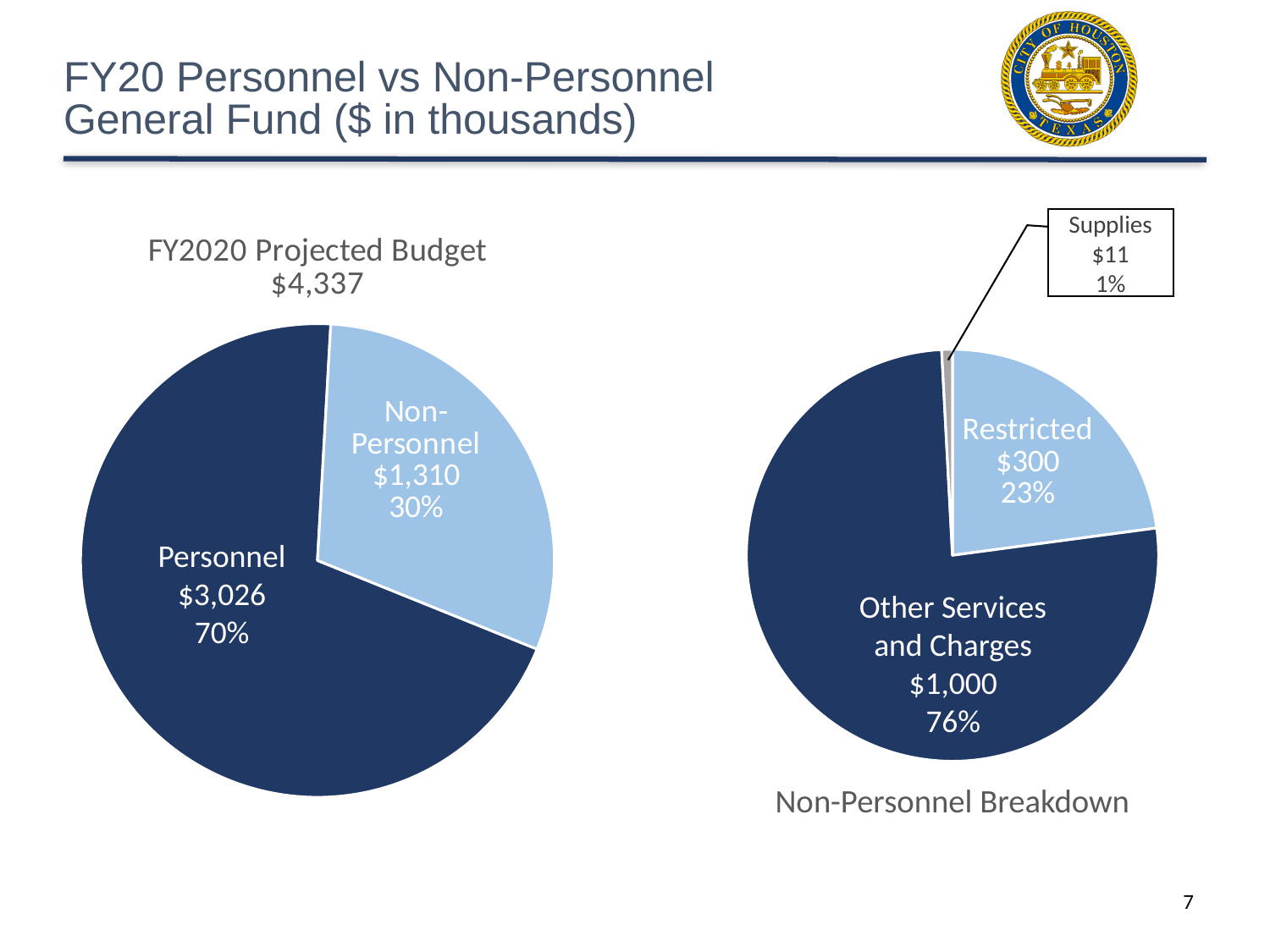
In the FY2020 Projected Budget chart, what share of the pie is Non-Personnel? 30% In the Non-Personnel Breakdown chart, which category is the smallest? Supplies In the FY2020 Projected Budget chart, what is the difference between Personnel and Non-Personnel? $1,716 In the Non-Personnel Breakdown chart, which is larger, Restricted or Other Services and Charges? Other Services and Charges What total is shown under the FY2020 Projected Budget chart title? $4,337 In the Non-Personnel Breakdown chart, what is the value for Restricted? $300 What kind of chart is the FY2020 Projected Budget chart? Pie chart In the FY2020 Projected Budget chart, which category is the largest? Personnel In the Non-Personnel Breakdown chart, what share of the pie is Other Services and Charges? 76% In the FY2020 Projected Budget chart, what is the value for Personnel? $3,026 In the Non-Personnel Breakdown chart, how many categories are shown? 3 In the Non-Personnel Breakdown chart, what is the value for Supplies? $11